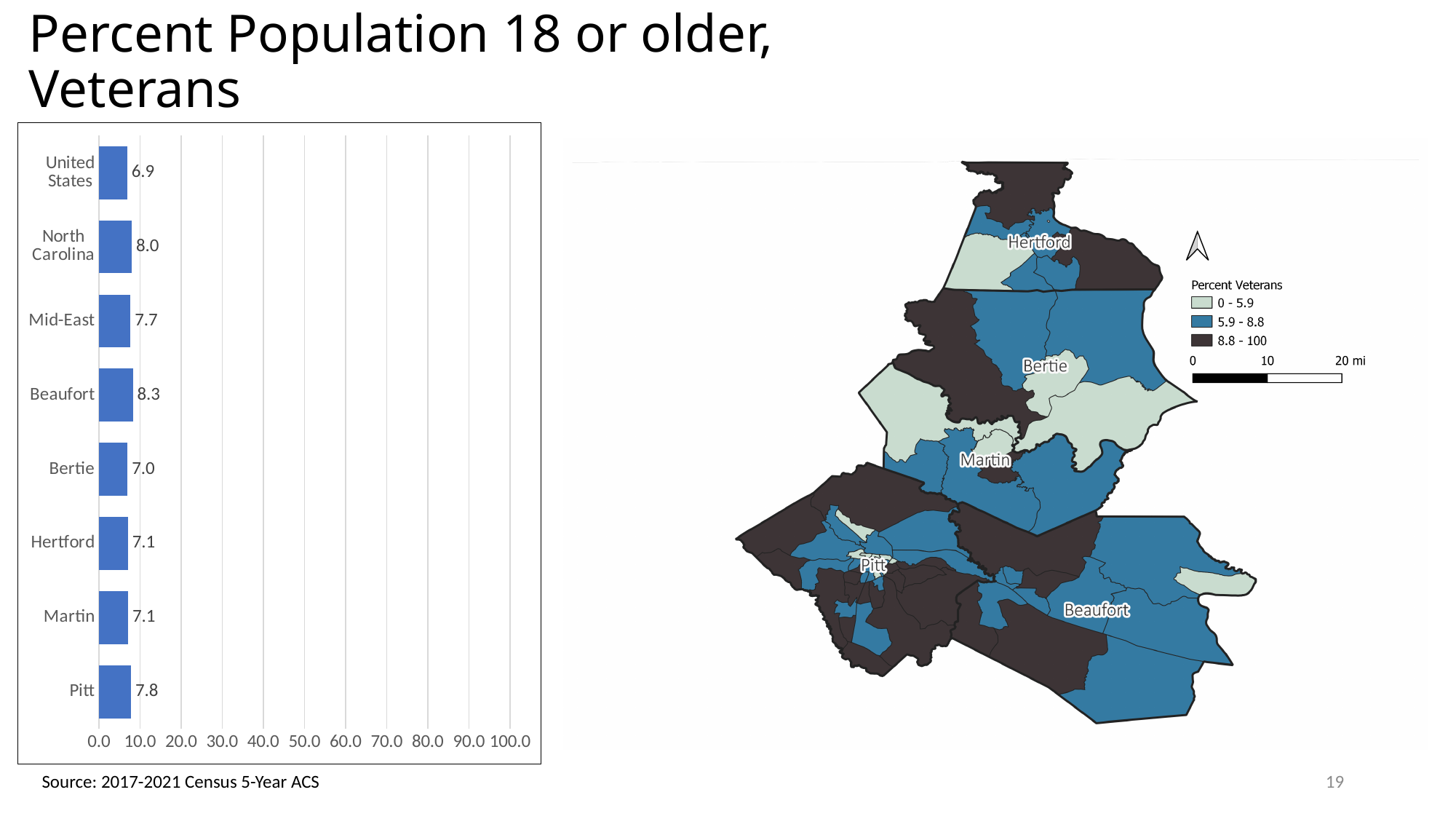
What kind of chart is shown on the left of the slide? bar chart What is the maximum value shown on the x axis of the bar chart? 100.0 What is the value for North Carolina in the bar chart? 8.0 What is the difference between the values for Beaufort and Bertie in the bar chart? 1.3 What is the value for Beaufort in the bar chart? 8.3 Which is larger in the bar chart, the value for Mid-East or the value for Pitt? Pitt What is the value for Pitt in the bar chart? 7.8 How many categories are shown in the bar chart? 8 Which category has the highest value in the bar chart? Beaufort Is the value for North Carolina in the bar chart greater or less than 10.0? less Which category has the lowest value in the bar chart? United States What is the value for the United States in the bar chart? 6.9